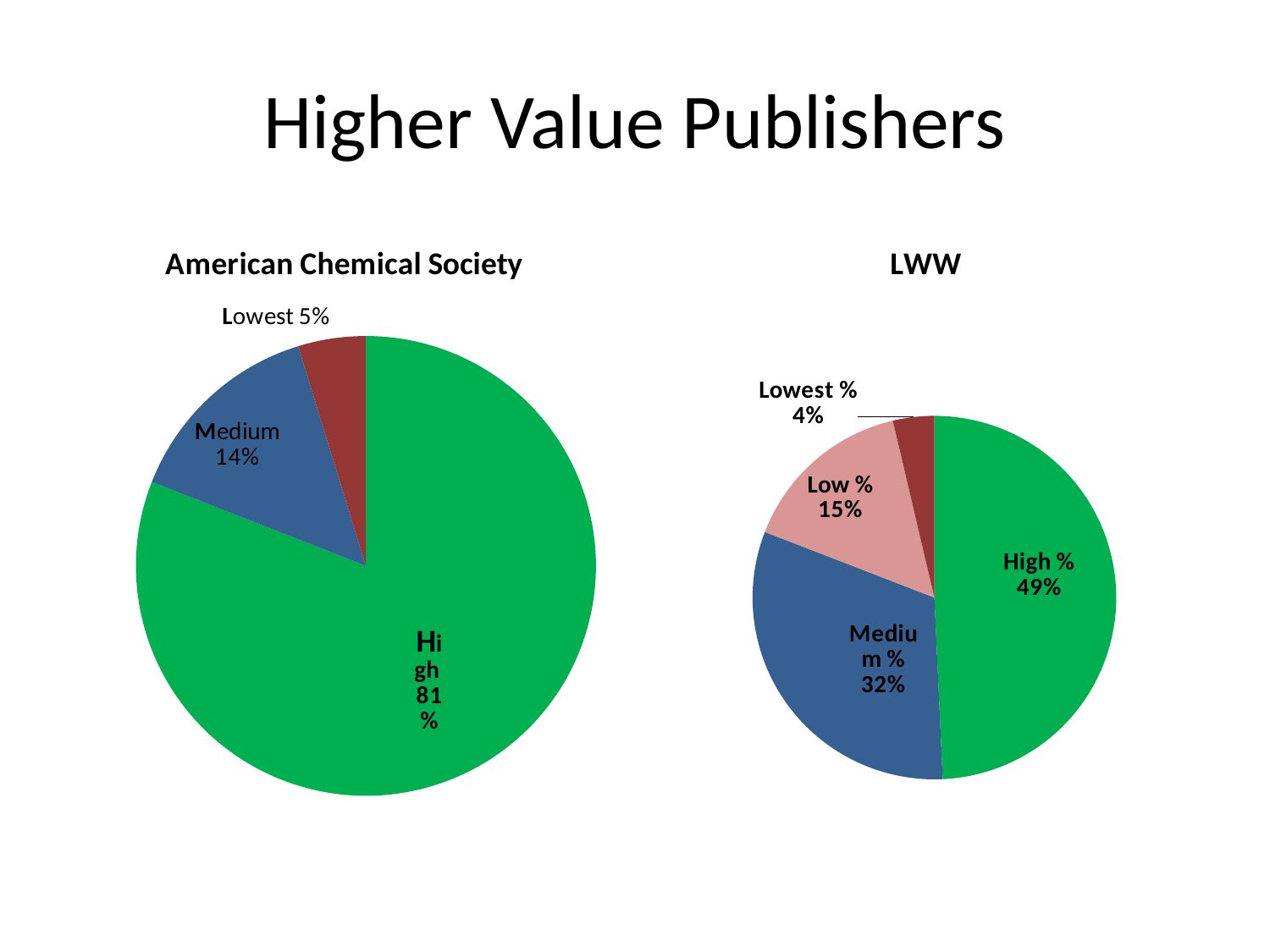
In the American Chemical Society chart, which slice is the smallest? Lowest In the LWW chart, how many slices does the pie have? 4 In the LWW chart, what percentage is the Lowest % slice? 4% In the American Chemical Society chart, what percentage is the Lowest slice? 5% What type of chart is the American Chemical Society chart? Pie chart In the LWW chart, what percentage is the Low % slice? 15% In the LWW chart, what is the difference between the Medium % slice and the Low % slice? 17% In the LWW chart, what percentage is the High % slice? 49% In the American Chemical Society chart, what percentage is the Medium slice? 14% In the LWW chart, which slice is the largest? High % In the American Chemical Society chart, how many slices does the pie have? 3 In the American Chemical Society chart, what percentage is the High slice? 81%